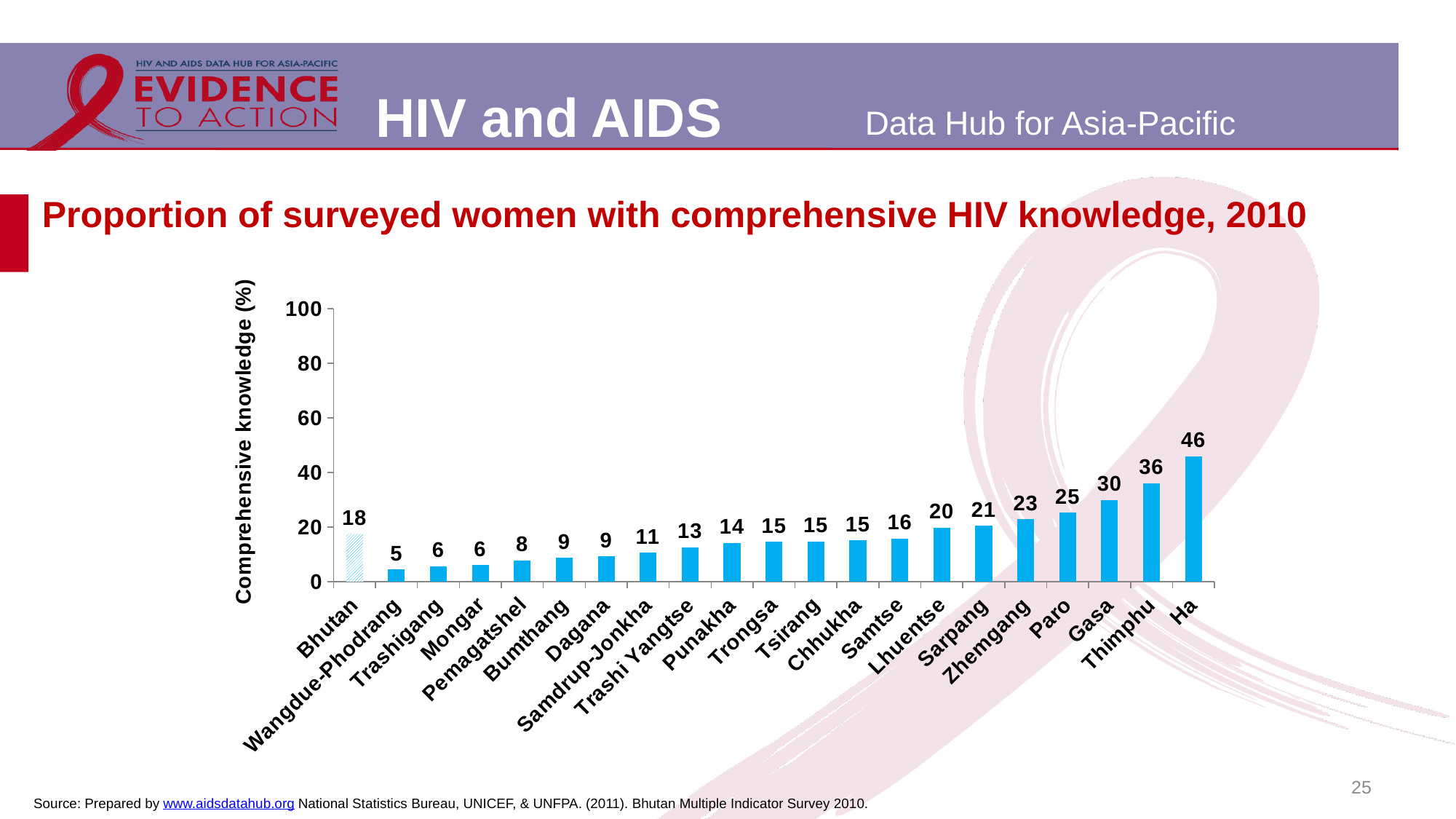
How many categories are shown on the x axis? 21 What kind of chart is shown on the slide? bar chart What is the difference between the values for Ha and Bhutan? 28 What is the value for Samdrup-Jonkha? 11 What is the label of the y axis? Comprehensive knowledge (%) What is the value for Ha? 46 What is the value for Thimphu? 36 Which category has the lowest value? Wangdue-Phodrang What is the value for Bhutan? 18 Which category has the highest value? Ha Is the value for Thimphu greater or less than 40? less Which is larger, the value for Paro or the value for Gasa? Gasa